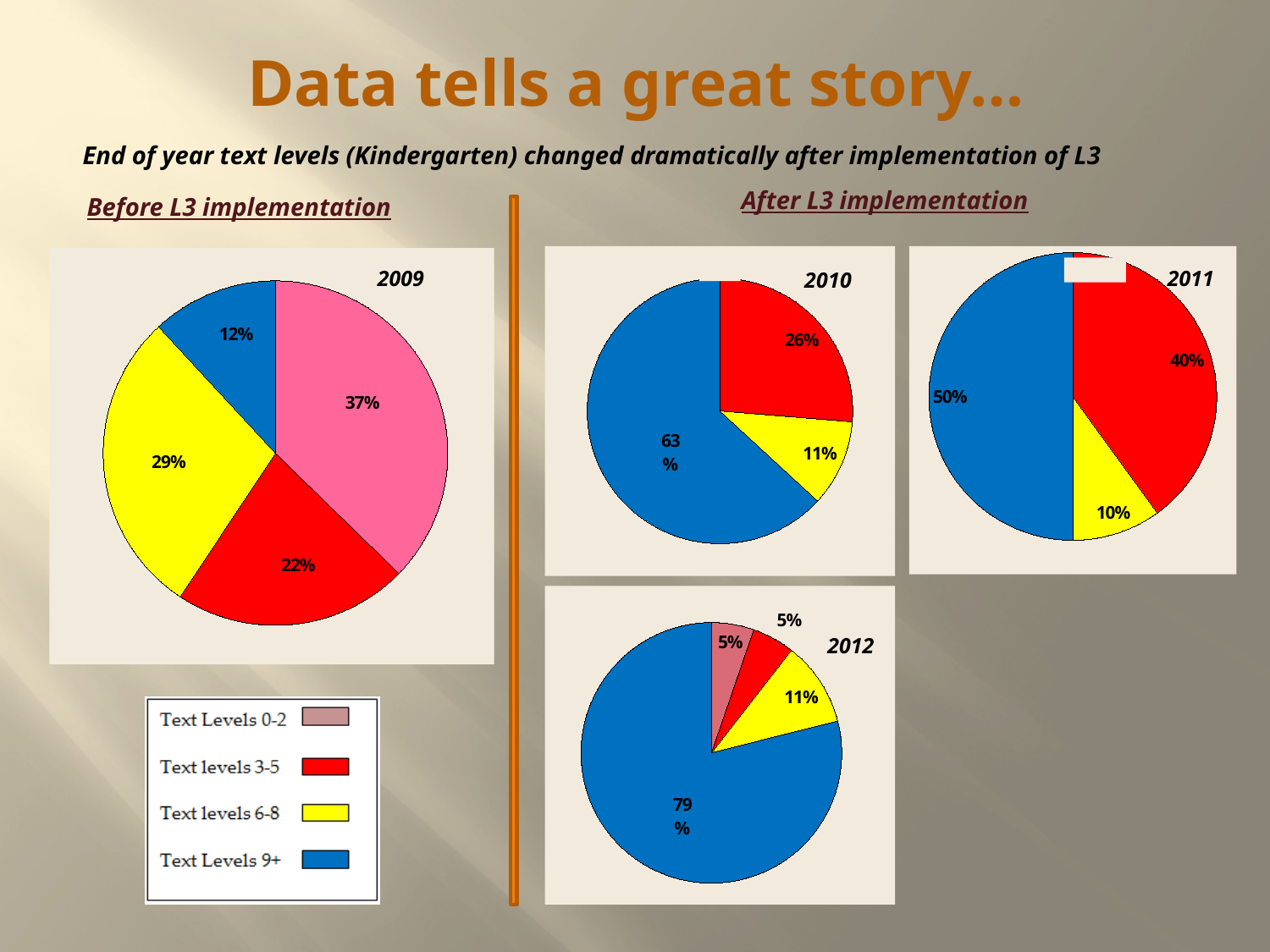
In the 2009 pie chart, what is the share of the largest slice? 37% In the 2012 pie chart, what share is shown for Text Levels 9+ (the blue slice)? 79% In the 2010 pie chart, what share is shown for Text Levels 9+ (the blue slice)? 63% By how many percentage points did the Text Levels 9+ share increase from the 2009 pie chart to the 2010 pie chart? 51 percentage points How many pie charts are on the slide? 4 In the 2011 pie chart, what share is shown for Text levels 3-5 (the red slice)? 40% In the 2012 pie chart, what share is shown for Text levels 6-8 (the yellow slice)? 11% Which pie chart shows a larger share for Text Levels 9+, 2010 or 2011? 2010 In the 2009 pie chart, what share is shown for Text Levels 9+ (the blue slice)? 12% How many categories does the legend list? 4 In the 2010 pie chart, which category has the smallest slice? Text levels 6-8 (11%) What kind of charts are shown on the slide? Pie charts